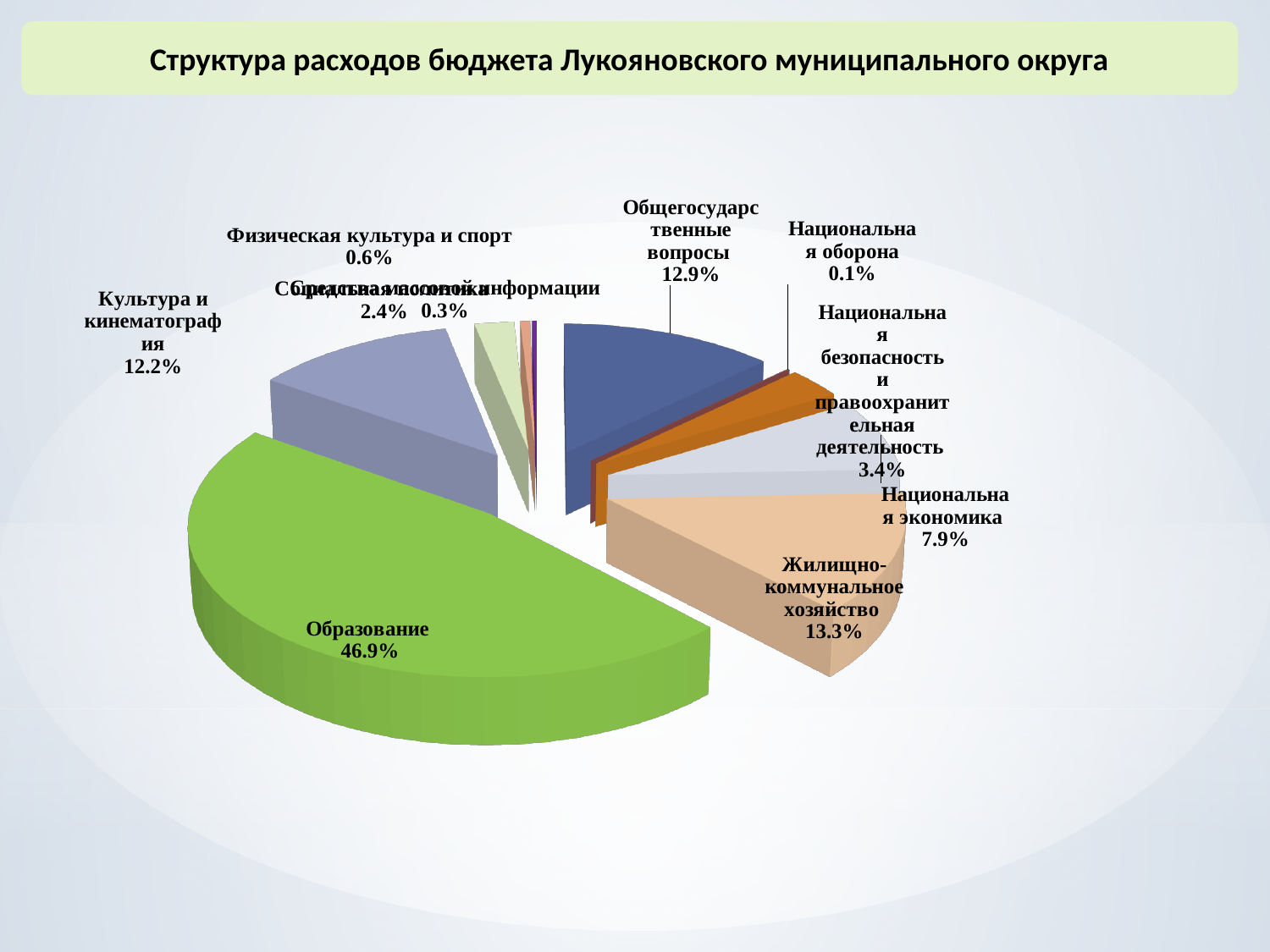
Which category has the smallest share of the budget expenditure? Национальная оборона What share of budget expenditure goes to Образование? 46.9% What is the value shown for Жилищно-коммунальное хозяйство? 13.3% What type of chart is shown on the slide? Pie chart What is the difference between the shares of Жилищно-коммунальное хозяйство and Общегосударственные вопросы? 0.4% What share is shown for Культура и кинематография? 12.2% Which has a larger share: Общегосударственные вопросы or Культура и кинематография? Общегосударственные вопросы What percentage is shown for Национальная безопасность и правоохранительная деятельность? 3.4% Which category has the largest share of the budget expenditure? Образование What percentage is shown for Общегосударственные вопросы? 12.9% What is the value for Физическая культура и спорт? 0.6% What is the value for Национальная экономика? 7.9%